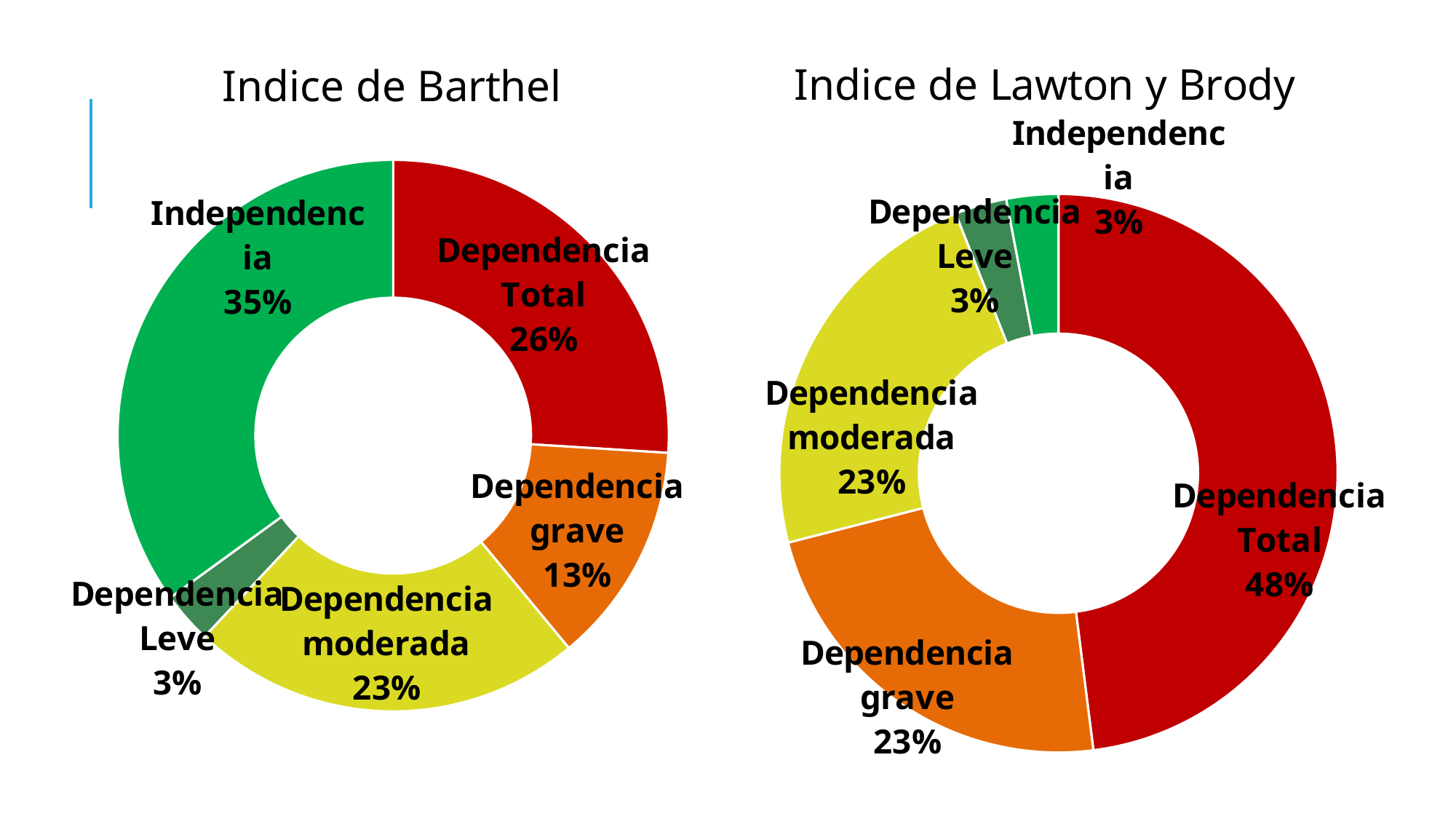
In the 'Indice de Barthel' chart, what share is labelled for Dependencia grave? 13% In the 'Indice de Barthel' chart, which category has the smallest share? Dependencia Leve In the 'Indice de Lawton y Brody' chart, what is the difference between the shares for Dependencia Total and Dependencia grave? 25% In the 'Indice de Lawton y Brody' chart, what share is labelled for Dependencia moderada? 23% Which is larger in the 'Indice de Barthel' chart: the share for Dependencia moderada or the share for Dependencia grave? Dependencia moderada In the 'Indice de Barthel' chart, which category has the largest share? Independencia In the 'Indice de Barthel' chart, what share is labelled for Independencia? 35% What kind of chart is the 'Indice de Barthel' chart? Doughnut (pie) chart In the 'Indice de Barthel' chart, what is the difference between the shares for Independencia and Dependencia Total? 9% How many categories does the 'Indice de Lawton y Brody' chart show? 5 In the 'Indice de Lawton y Brody' chart, what share is labelled for Dependencia Total? 48% In the 'Indice de Lawton y Brody' chart, which category has the largest share? Dependencia Total